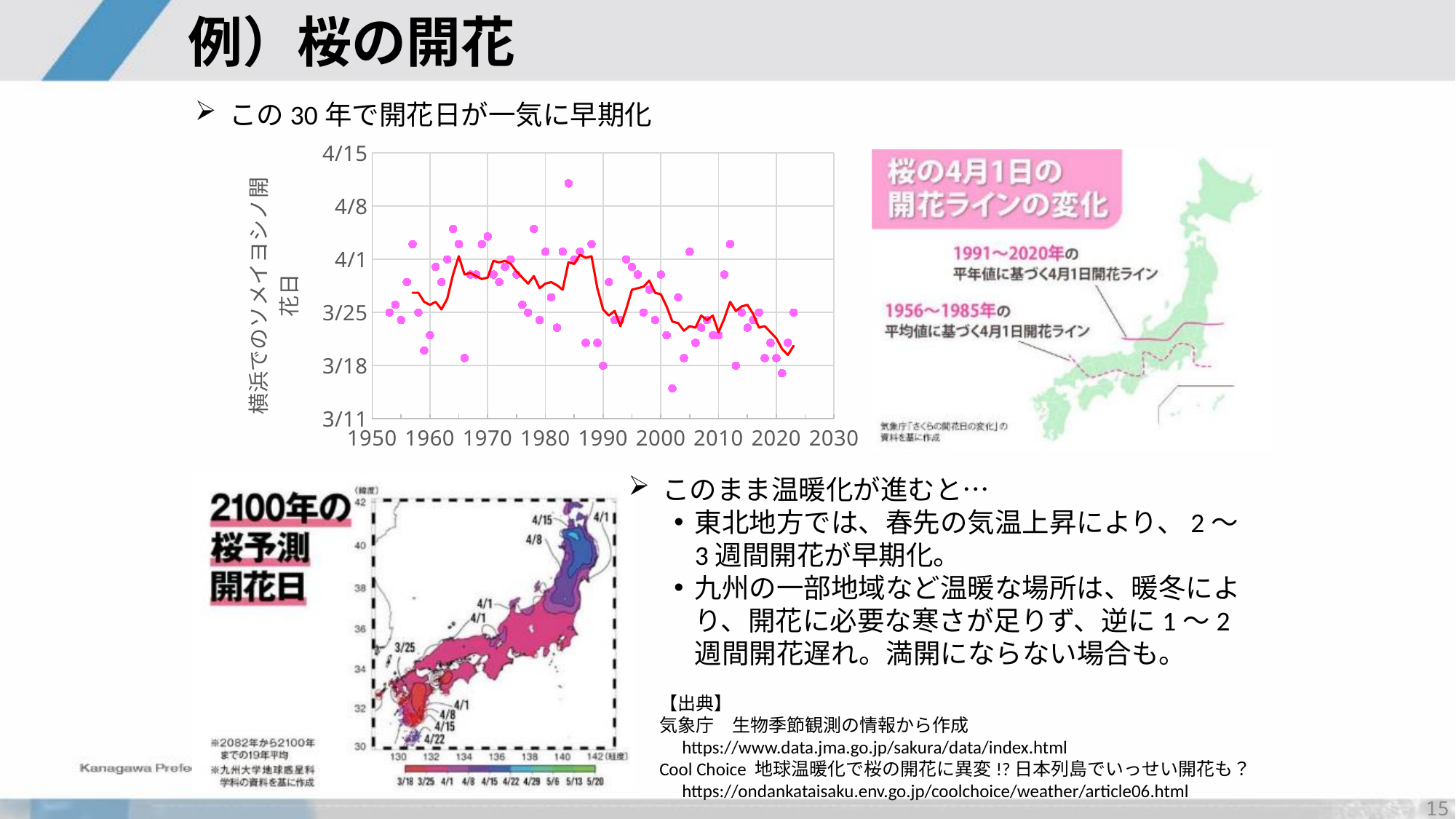
What is the lowest tick shown on the y axis of the scatter chart? 3/11 In the scatter chart, is the highest plotted point (around 1983) later or earlier than 4/8? later In the scatter chart, which decade has the highest plotted point: the 1980s or the 2010s? 1980s What is the highest tick shown on the y axis of the scatter chart? 4/15 In the chart of Yokohama cherry blossom flowering dates, do the values generally rise or fall as the years go from 1950 to 2030? fall What kind of chart is shown on the left of the slide (the one with years on the x axis)? scatter chart with a trend line What is the last year tick shown on the x axis of the scatter chart? 2030 What is the first year tick shown on the x axis of the scatter chart? 1950 In the scatter chart, is the lowest plotted point (around 2001) earlier or later than 3/18? earlier In the scatter chart, is the red trend line around 1965 later or earlier than 3/25? later What is the label on the y axis of the scatter chart? 横浜でのソメイヨシノ開花日